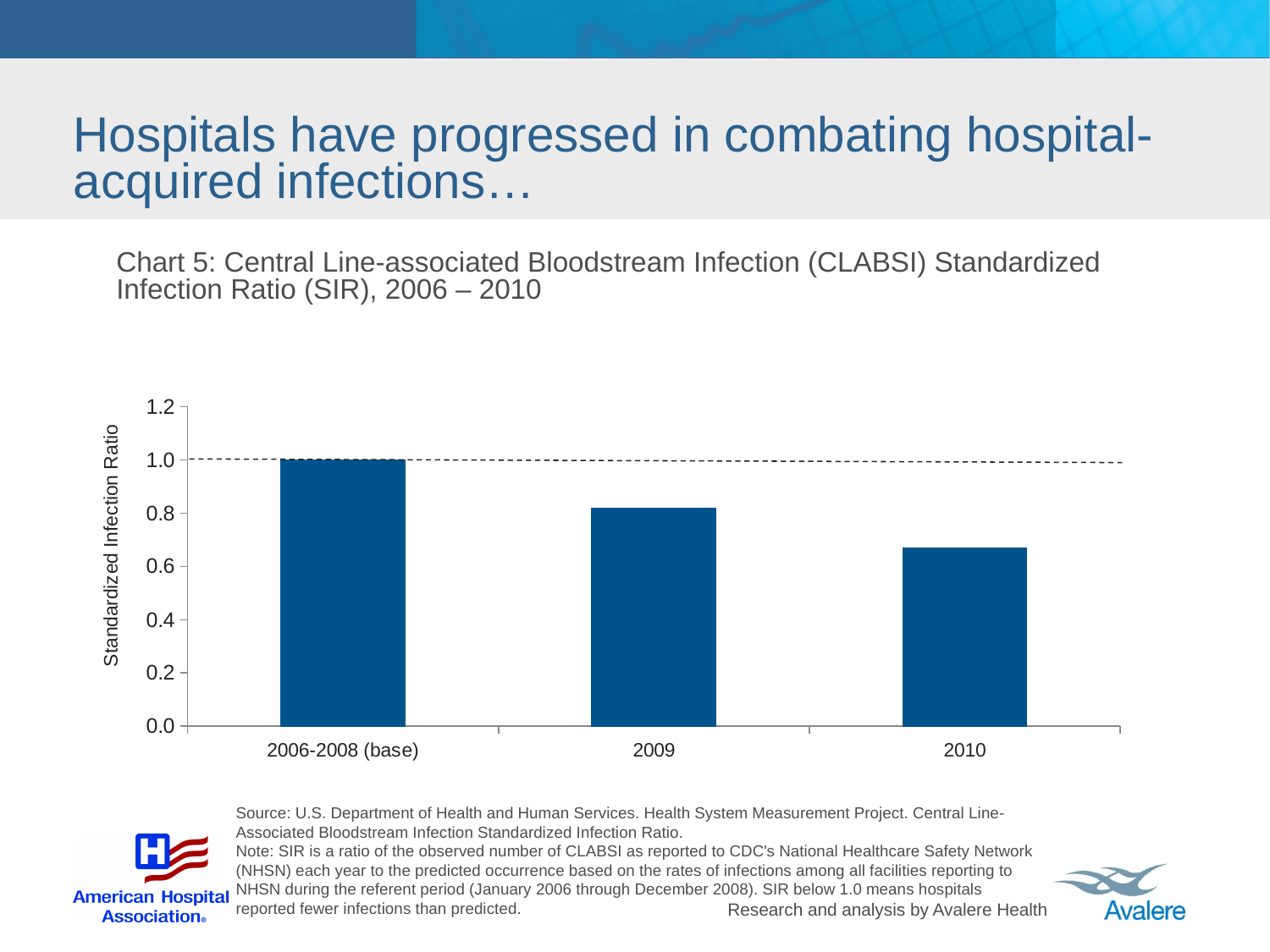
Is the value for 2009 greater or less than 0.6? greater Which category has the lowest Standardized Infection Ratio? 2010 Do the values rise or fall from 2006-2008 (base) to 2010? fall Which category has the highest Standardized Infection Ratio? 2006-2008 (base) What is the label on the vertical axis of the chart? Standardized Infection Ratio Is the value for 2009 greater or less than 1.0? less What is the Standardized Infection Ratio for 2006-2008 (base)? 1.0 What kind of chart is shown on the slide? bar chart How many bars (categories) are plotted in the chart? 3 Is the value for 2010 greater or less than 0.8? less Which is larger, the value for 2009 or the value for 2010? 2009